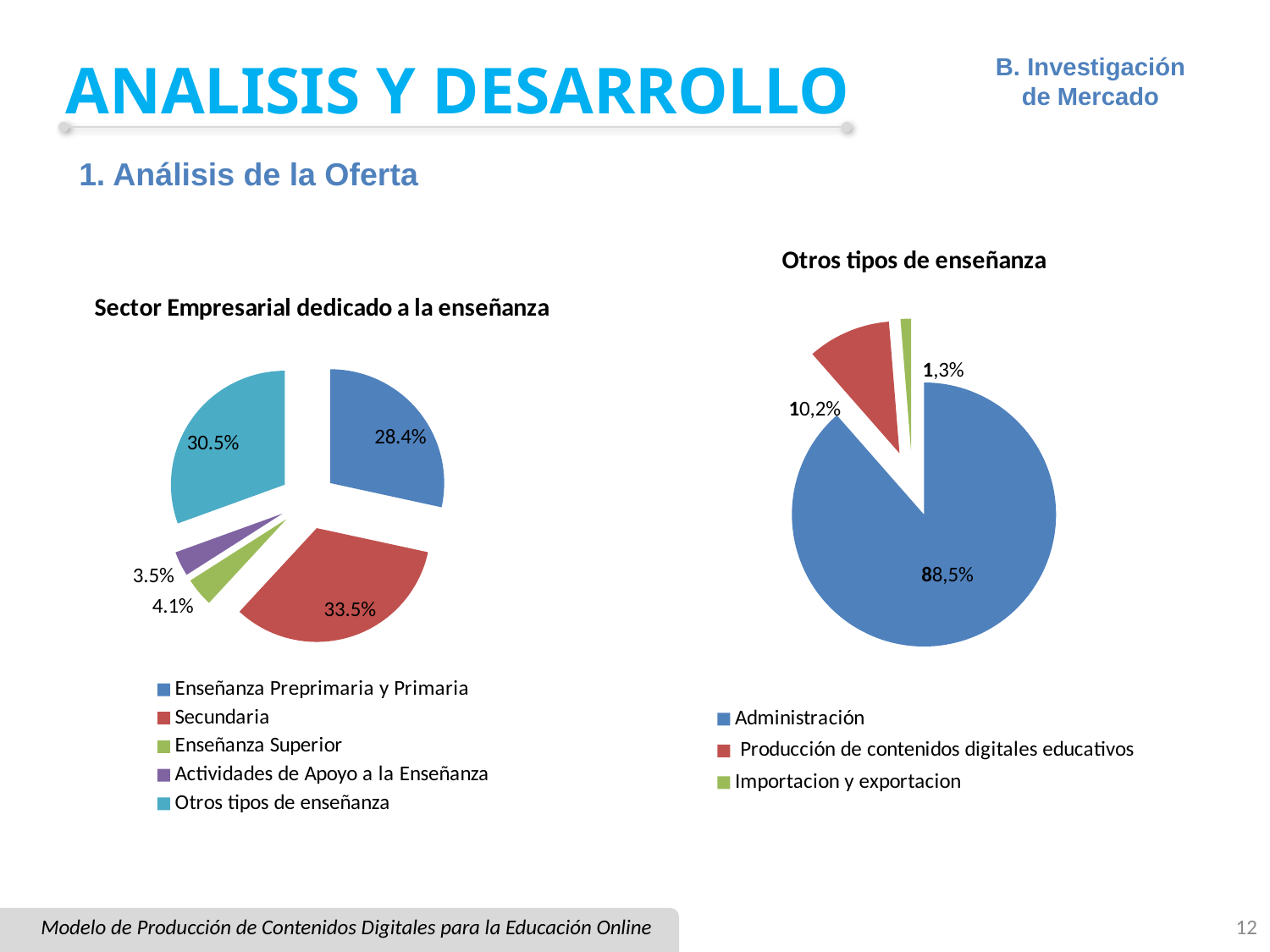
What type of chart is the chart titled 'Otros tipos de enseñanza'? Pie chart In the chart titled 'Otros tipos de enseñanza', which category has the smallest slice? Importacion y exportacion In the chart titled 'Sector Empresarial dedicado a la enseñanza', which category has the smallest slice? Actividades de Apoyo a la Enseñanza In the chart titled 'Sector Empresarial dedicado a la enseñanza', what share does Actividades de Apoyo a la Enseñanza have? 3.5% In the chart titled 'Sector Empresarial dedicado a la enseñanza', what share does Enseñanza Preprimaria y Primaria have? 28.4% In the chart titled 'Otros tipos de enseñanza', what share does Administración have? 88,5% In the chart titled 'Sector Empresarial dedicado a la enseñanza', which category has the largest slice? Secundaria In the chart titled 'Otros tipos de enseñanza', what share does Producción de contenidos digitales educativos have? 10,2% In the chart titled 'Otros tipos de enseñanza', how many categories does the legend list? 3 In the chart titled 'Sector Empresarial dedicado a la enseñanza', how many categories does the legend list? 5 In the chart titled 'Sector Empresarial dedicado a la enseñanza', what is the difference between the Secundaria and Enseñanza Superior shares? 29.4% In the chart titled 'Sector Empresarial dedicado a la enseñanza', what share does Secundaria have? 33.5%